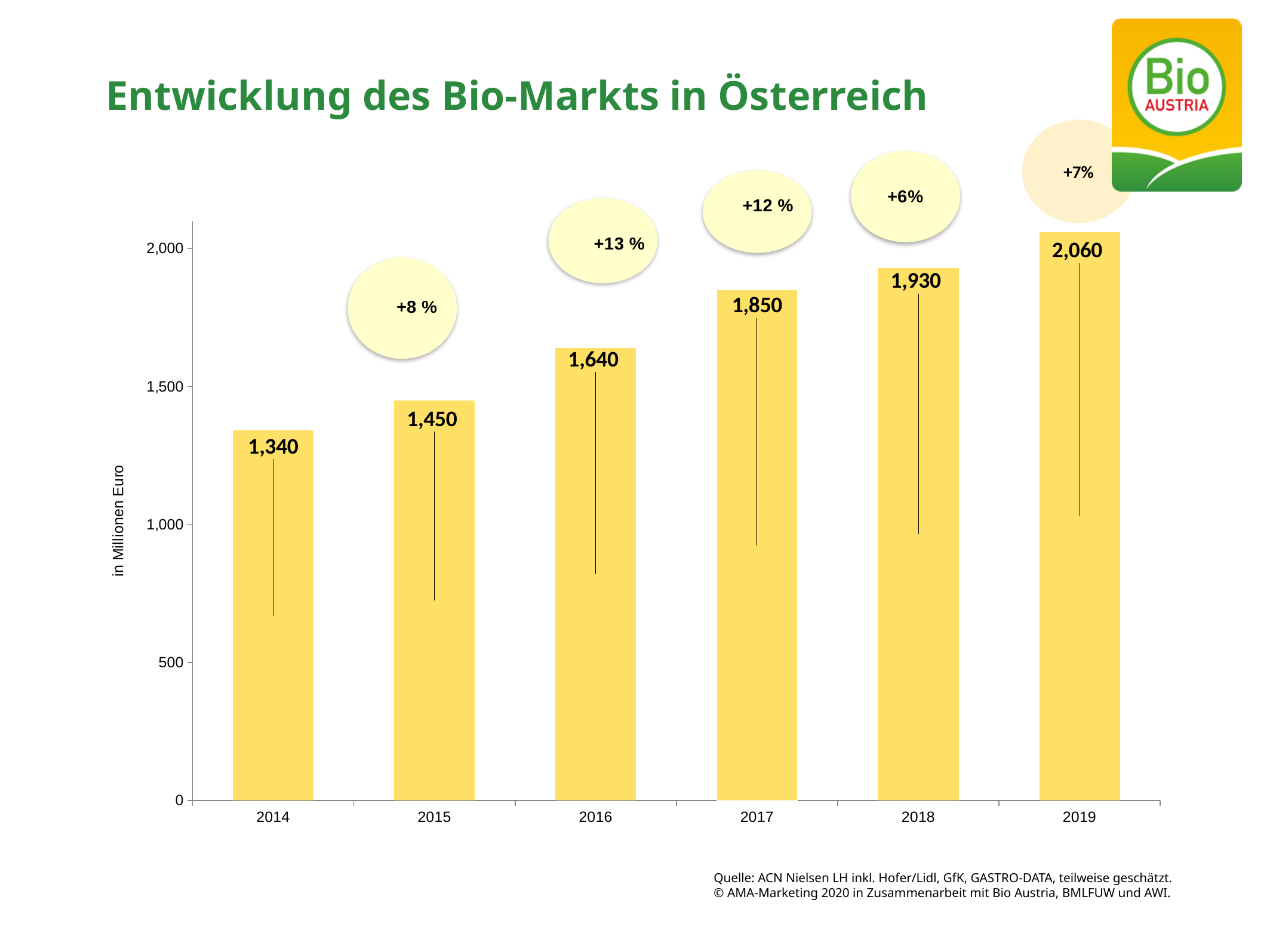
Is the value for 2018 greater or less than 2,000? less What is the value for 2014? 1,340 What is the value for 2019? 2,060 Do the values rise or fall from 2014 to 2019? rise How many years are shown on the x axis? 6 Which year has the lowest value? 2014 Which is larger, the value for 2018 or the value for 2016? 2018 What kind of chart is shown on the slide? bar chart What is the difference between the values for 2016 and 2015? 190 Which year has the highest value? 2019 What is the value for 2017? 1,850 What is the difference between the values for 2019 and 2014? 720